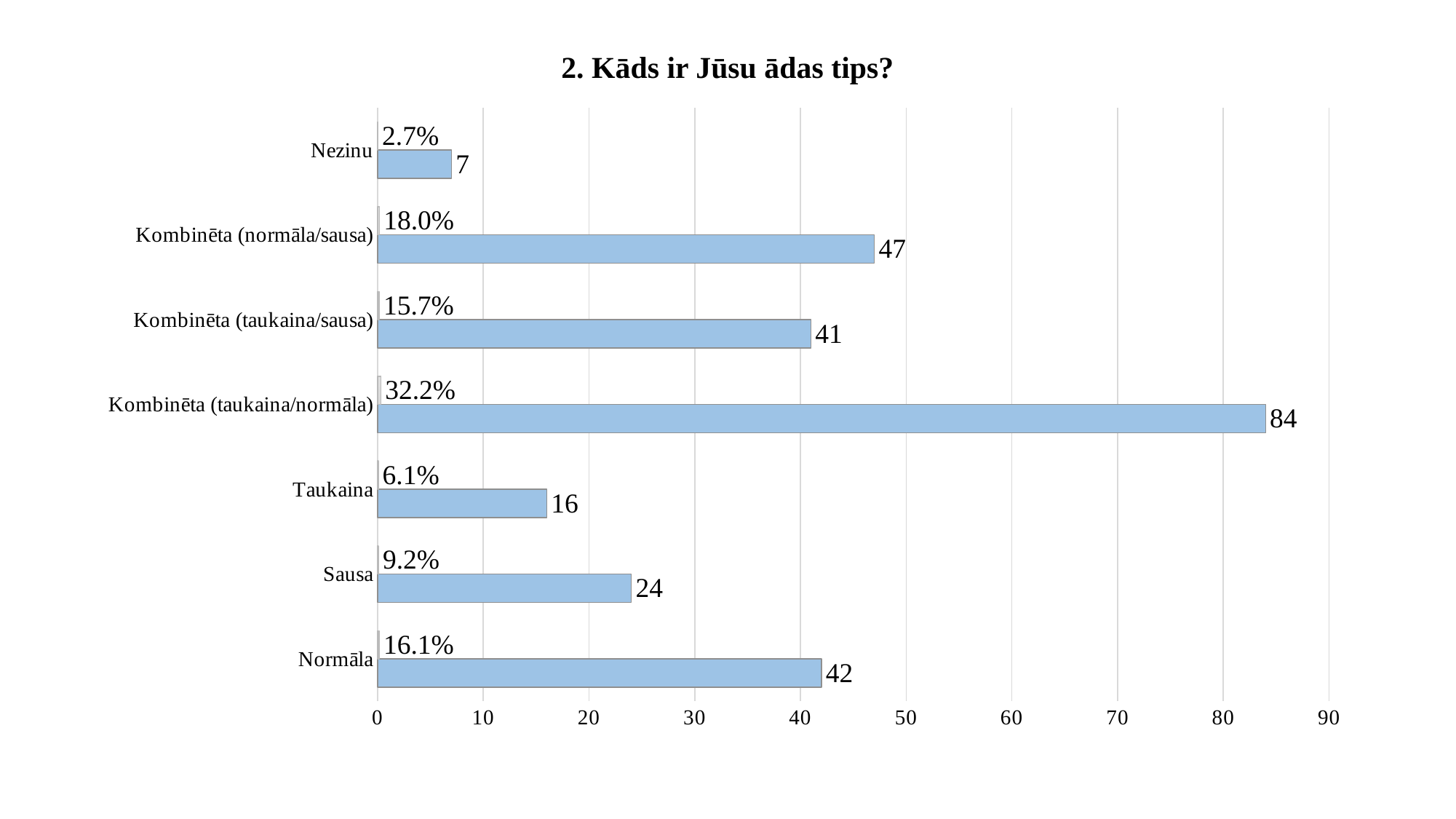
Is the count for Kombinēta (taukaina/normāla) greater or less than 80? greater Which has a larger count, Sausa or Taukaina? Sausa What is the title of the chart? 2. Kāds ir Jūsu ādas tips? What percentage is shown for Sausa? 9.2% What is the count value for Normāla? 42 Which category has the lowest count? Nezinu Which category has the highest count? Kombinēta (taukaina/normāla) What percentage is shown for Kombinēta (taukaina/normāla)? 32.2% What is the difference between the counts for Kombinēta (normāla/sausa) and Kombinēta (taukaina/sausa)? 6 What is the count value for Nezinu? 7 How many categories are shown in the chart? 7 What kind of chart is this? bar chart